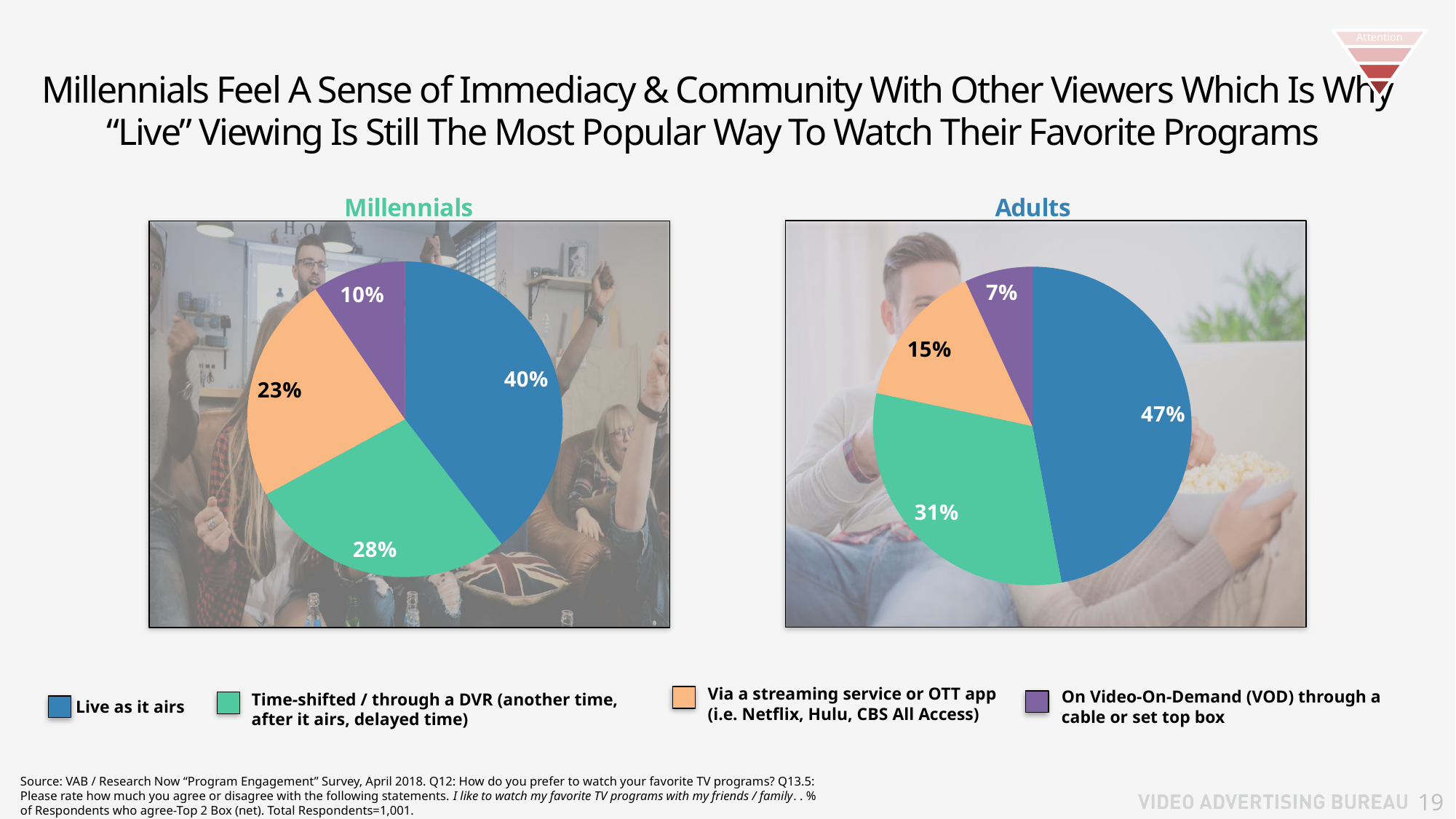
How many categories does the legend list? 4 In the Millennials pie chart, what share is Live as it airs? 40% Which group has a larger share for Via a streaming service or OTT app, Millennials or Adults? Millennials In the Millennials pie chart, what share is Via a streaming service or OTT app? 23% What colour represents Time-shifted / through a DVR in the legend? Green What type of chart is used for the Adults data? Pie chart In the Adults pie chart, which category has the smallest share? On Video-On-Demand (VOD) through a cable or set top box In the Adults pie chart, what share is On Video-On-Demand (VOD) through a cable or set top box? 7% In the Adults pie chart, what share is Time-shifted / through a DVR? 31% What is the difference between the Live as it airs share for Adults and for Millennials? 7 percentage points How many slices does the Millennials pie chart have? 4 In the Millennials pie chart, which category has the largest share? Live as it airs